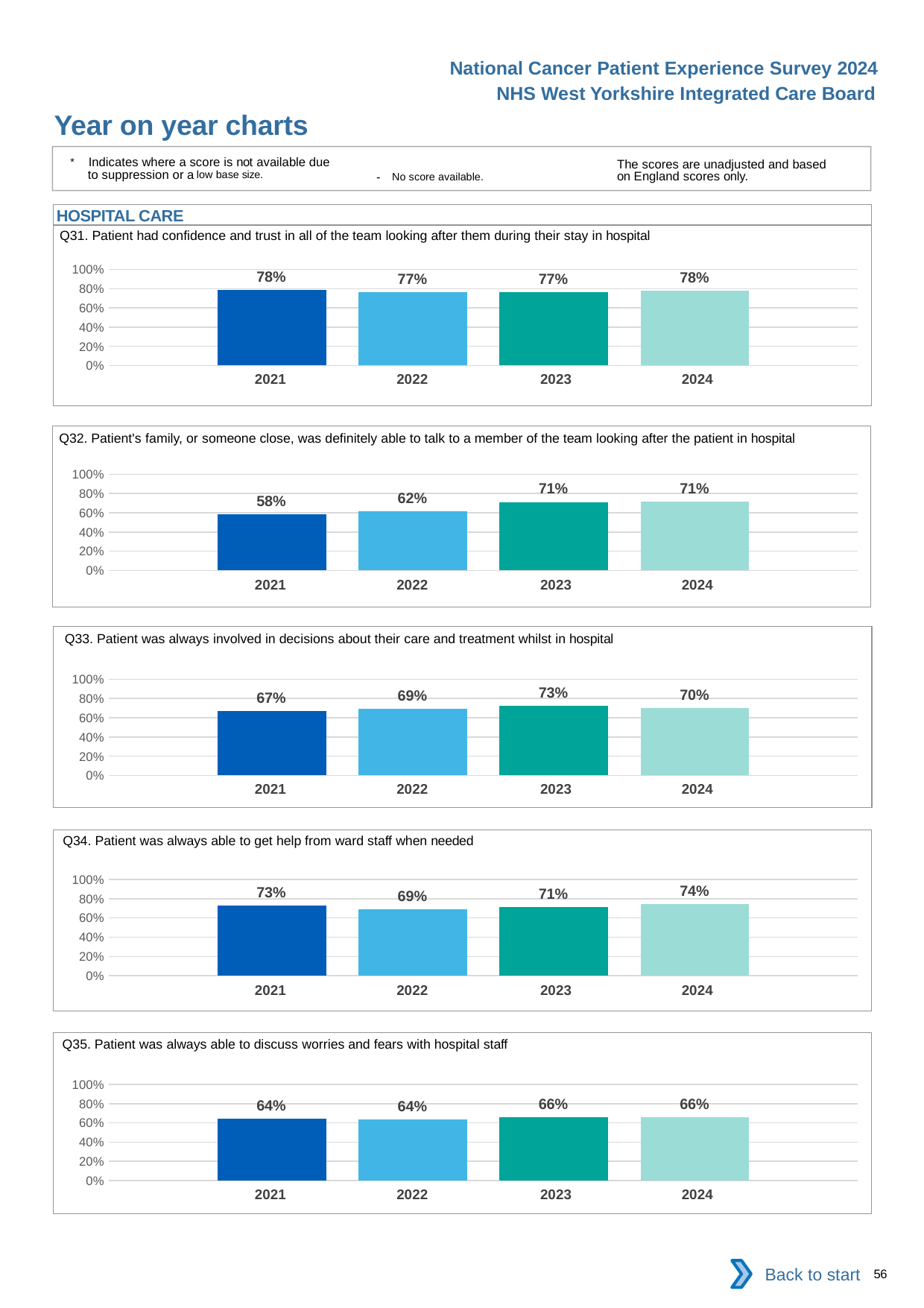
In the Q34 chart, which is larger, the value for 2022 or the value for 2024? 2024 In the Q33 chart, which year has the highest value? 2023 How many years are shown in the Q31 chart? 4 In the Q32 chart, which year has the lowest value? 2021 In the Q33 chart, what is the value for 2024? 70% In the Q32 chart, what is the difference between the 2023 value and the 2021 value? 13% In the Q34 chart, what is the difference between the 2024 value and the 2022 value? 5% In the Q31 chart, what is the value for 2021? 78% In the Q32 chart, do the values rise or fall from 2021 to 2023? rise In the Q35 chart, is the value for 2021 greater or less than 80%? less What kind of chart is the Q32 chart? bar chart In the Q35 chart, what is the value for 2023? 66%